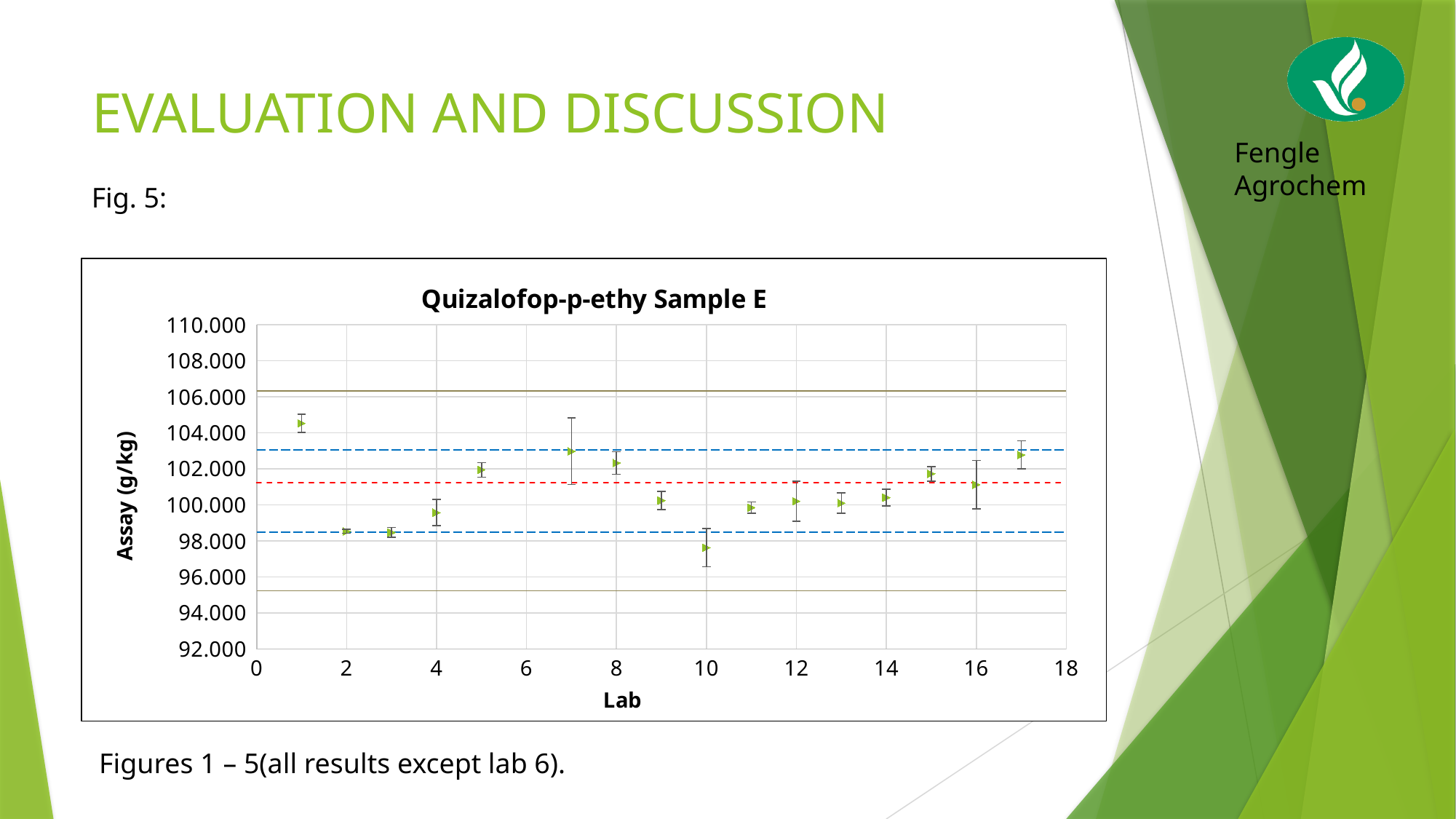
Is the assay value for Lab 4 greater or less than 100.000? less How many labs have a data point plotted on the chart? 16 Which has the larger assay value, Lab 7 or Lab 3? Lab 7 What is the label of the vertical axis? Assay (g/kg) Is the assay value for Lab 10 greater or less than 98.000? less Is the assay value for Lab 1 greater or less than 104.000? greater What kind of chart is shown on the slide? scatter chart Which lab has the highest assay value? Lab 1 Which lab has the lowest assay value? Lab 10 Which has the larger assay value, Lab 1 or Lab 10? Lab 1 What is the title of the chart? Quizalofop-p-ethy Sample E